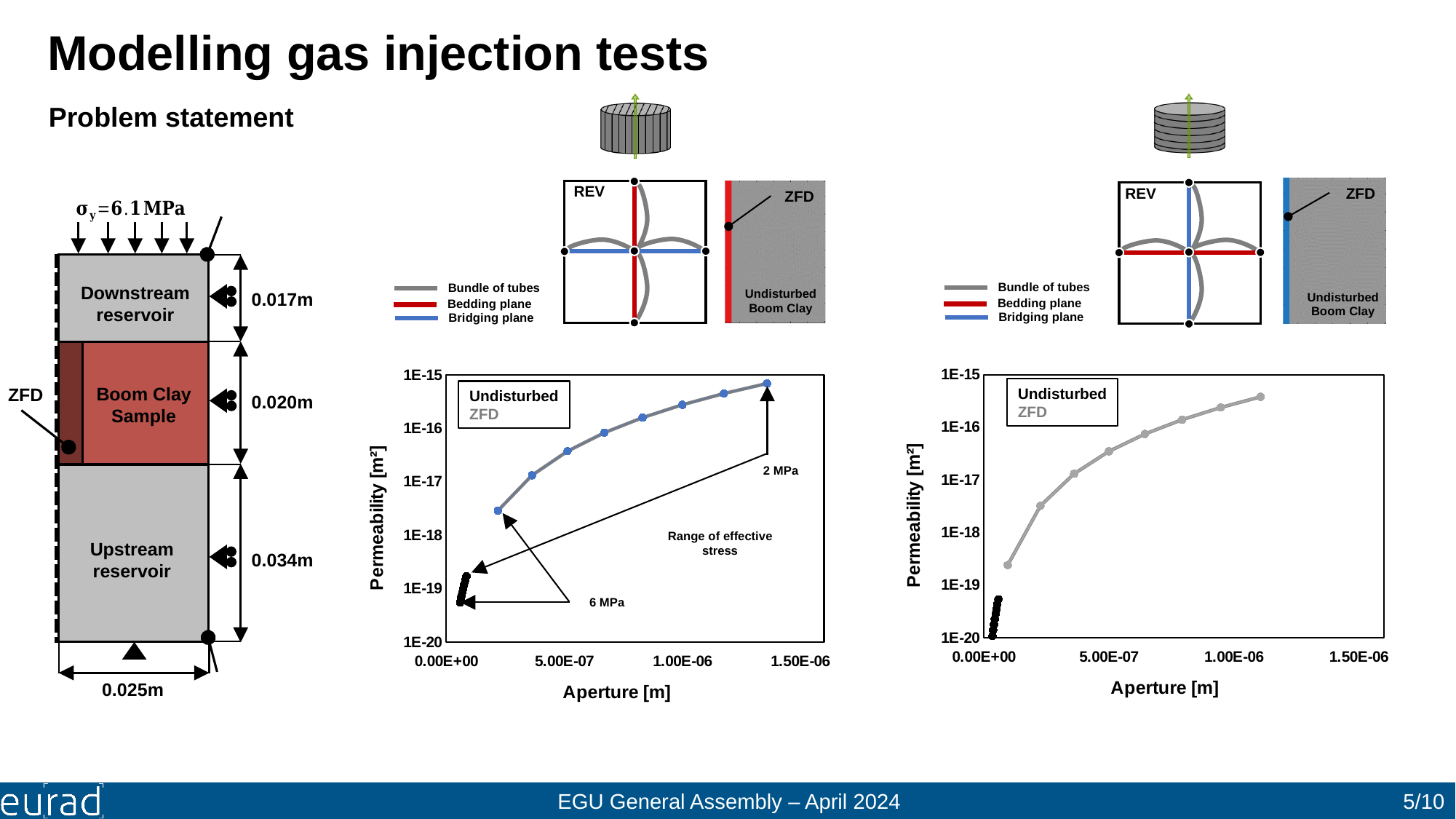
In the right Permeability versus Aperture chart, does permeability rise or fall as aperture increases? Rises In the left Permeability versus Aperture chart, is the permeability at an aperture of 5.00E-07 m greater or less than 1E-18? greater In the right Permeability versus Aperture chart, is the highest plotted permeability greater or less than 1E-16? greater In the left Permeability versus Aperture chart, what is the lowest value shown on the y axis? 1E-20 In the right Permeability versus Aperture chart, what are the two series named in the legend? Undisturbed and ZFD In the left Permeability versus Aperture chart, does permeability rise or fall as aperture increases? Rises In the left Permeability versus Aperture chart, which series reaches the higher permeability, Undisturbed or ZFD? ZFD What kind of chart is the left chart of Permeability versus Aperture? Line chart with markers In the left Permeability versus Aperture chart, is the permeability at an aperture of 1.00E-06 m greater or less than 1E-17? greater In the left Permeability versus Aperture chart, how many series does the legend list? 2 In the left Permeability versus Aperture chart, what is the label of the x axis? Aperture [m]